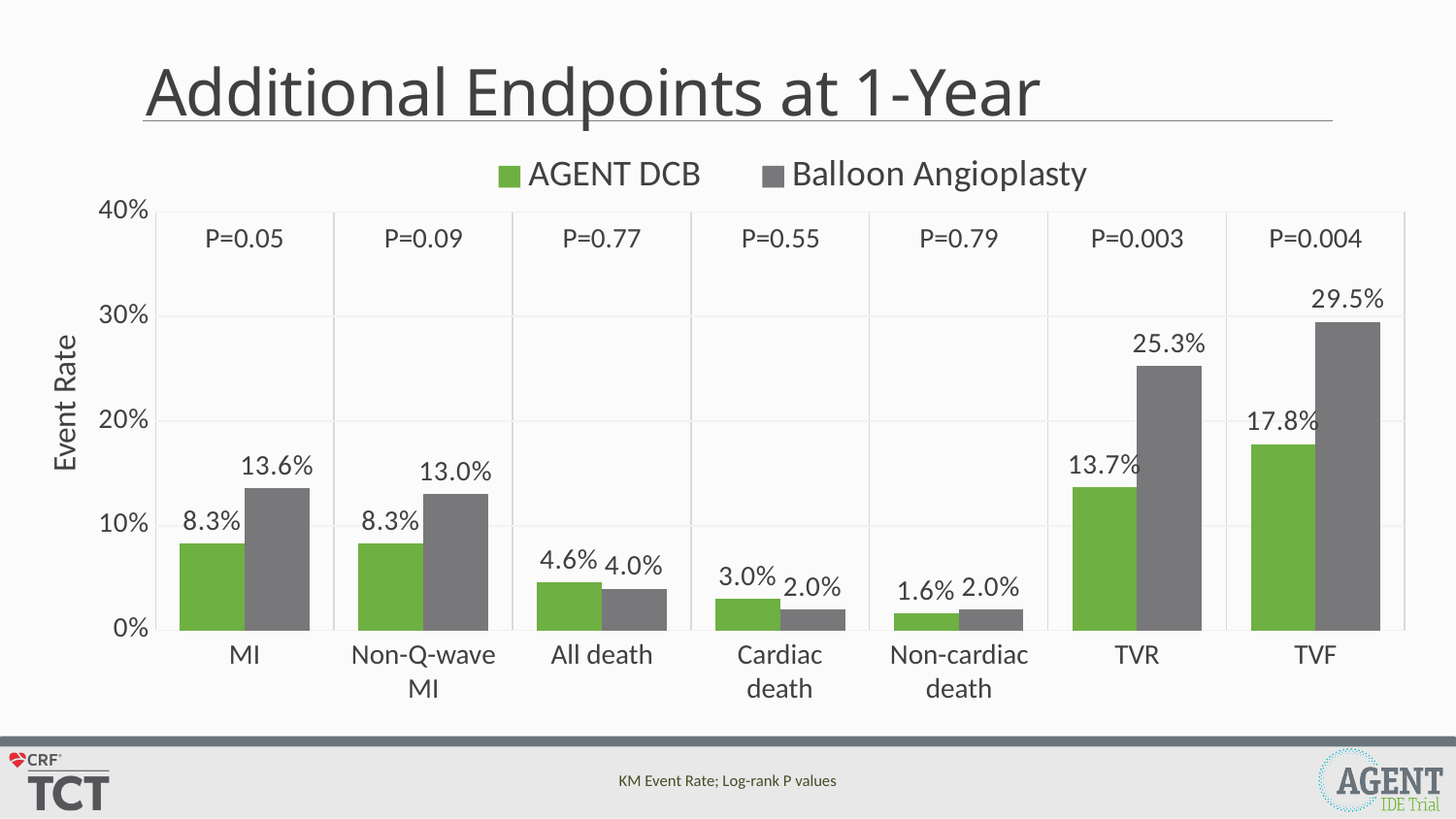
What is the difference between the Balloon Angioplasty and AGENT DCB event rates for TVR? 11.6% Which category has the lowest AGENT DCB event rate? Non-cardiac death Is the Balloon Angioplasty event rate for TVF greater or less than 20%? greater What type of chart is shown on the slide? Bar chart For All death, which series has the higher event rate, AGENT DCB or Balloon Angioplasty? AGENT DCB What is the AGENT DCB event rate for TVF? 17.8% What is the AGENT DCB event rate for Non-cardiac death? 1.6% How many endpoint categories are shown on the x axis? 7 How many series does the legend list? 2 Which category has the highest Balloon Angioplasty event rate? TVF What is the Balloon Angioplasty event rate for TVR? 25.3% What is the difference between the Balloon Angioplasty and AGENT DCB event rates for MI? 5.3%